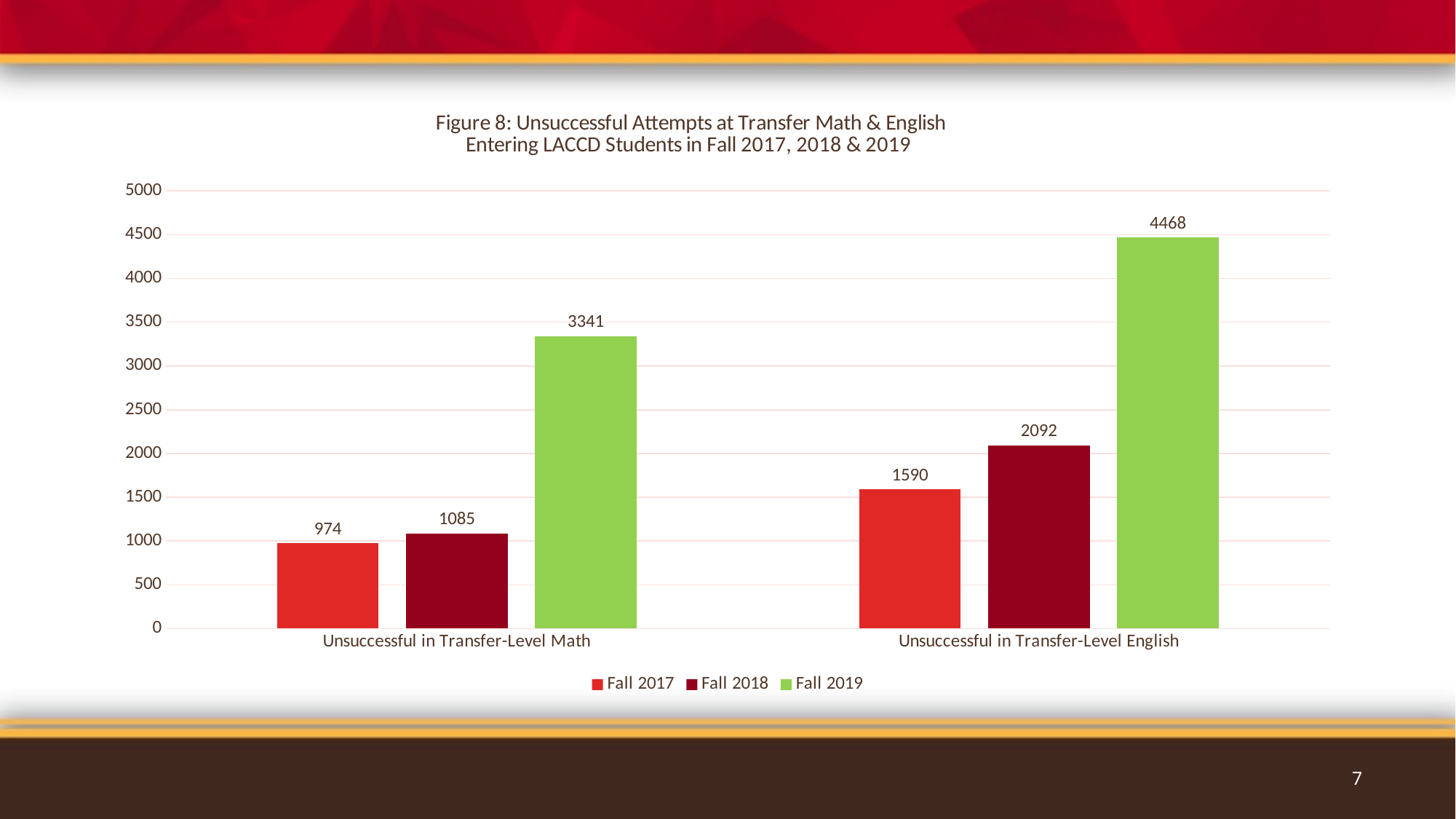
How many categories are shown on the x axis? 2 Which series has the lowest value for Unsuccessful in Transfer-Level Math? Fall 2017 How many series does the legend list? 3 Which is larger: the Fall 2017 value for Transfer-Level English or the Fall 2018 value for Transfer-Level Math? Fall 2017 value for Transfer-Level English Do the values for Unsuccessful in Transfer-Level Math rise or fall from Fall 2017 to Fall 2019? Rise What kind of chart is shown on the slide? Bar chart What is the Fall 2018 value for Unsuccessful in Transfer-Level Math? 1085 What is the Fall 2017 value for Unsuccessful in Transfer-Level English? 1590 What is the Fall 2019 value for Unsuccessful in Transfer-Level Math? 3341 What is the difference between the Fall 2018 and Fall 2017 values for Unsuccessful in Transfer-Level Math? 111 Which series has the highest value for Unsuccessful in Transfer-Level English? Fall 2019 What is the difference between the Fall 2019 and Fall 2018 values for Unsuccessful in Transfer-Level English? 2376